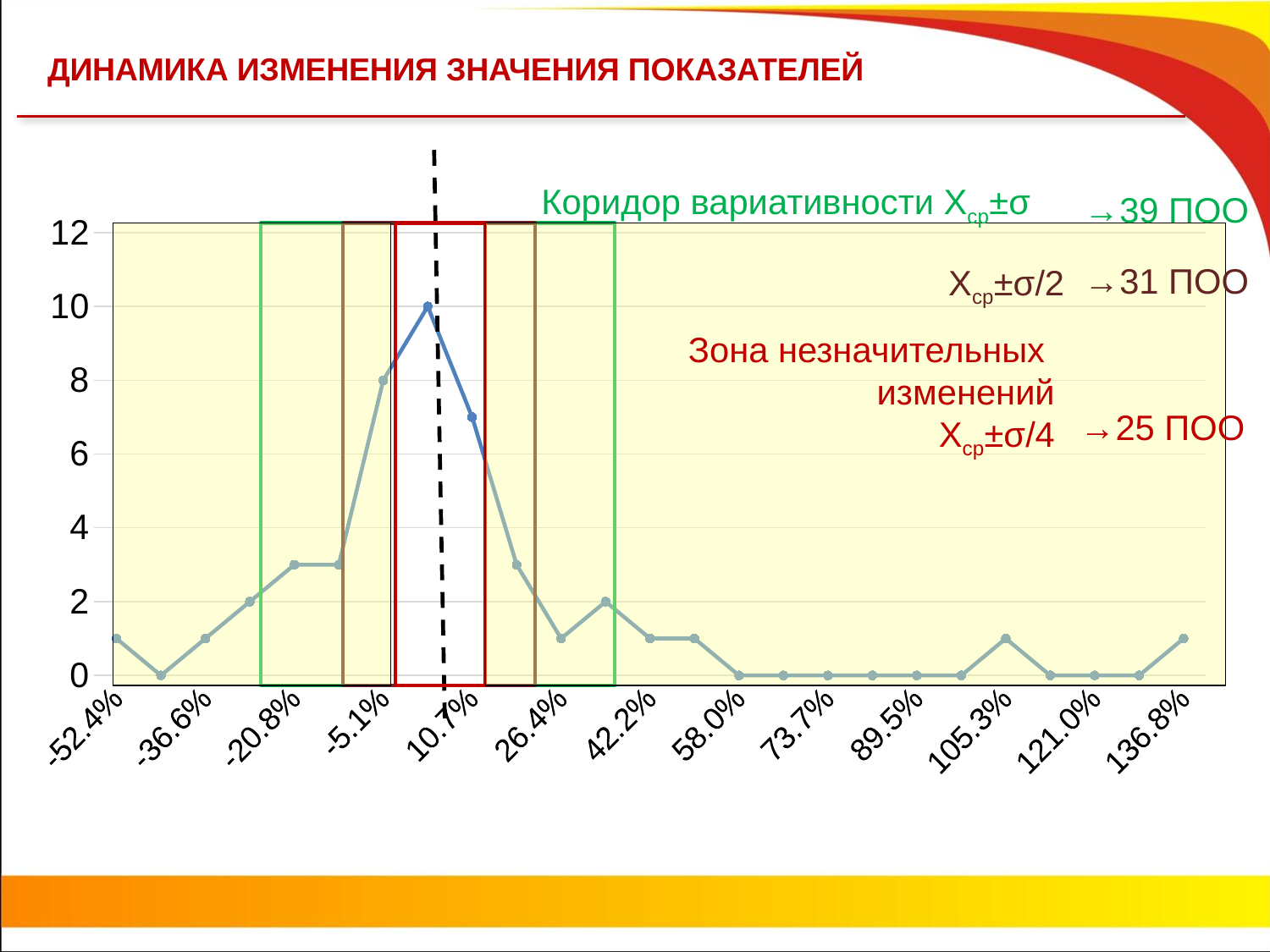
Is the value at 105.3% greater or less than 2? less Is the value at -20.8% greater or less than 4? less What is the highest value shown on the vertical axis? 12 What is the value at 58.0%? 0 What is the value at 89.5%? 0 What kind of chart is shown on the slide? line chart Which is larger, the value at 10.7% or the value at 42.2%? 10.7% What is the value at -5.1%? 8 What is the highest value reached by the line? 10 Is the value at 10.7% greater or less than 6? greater Which is larger, the value at -5.1% or the value at 26.4%? -5.1%